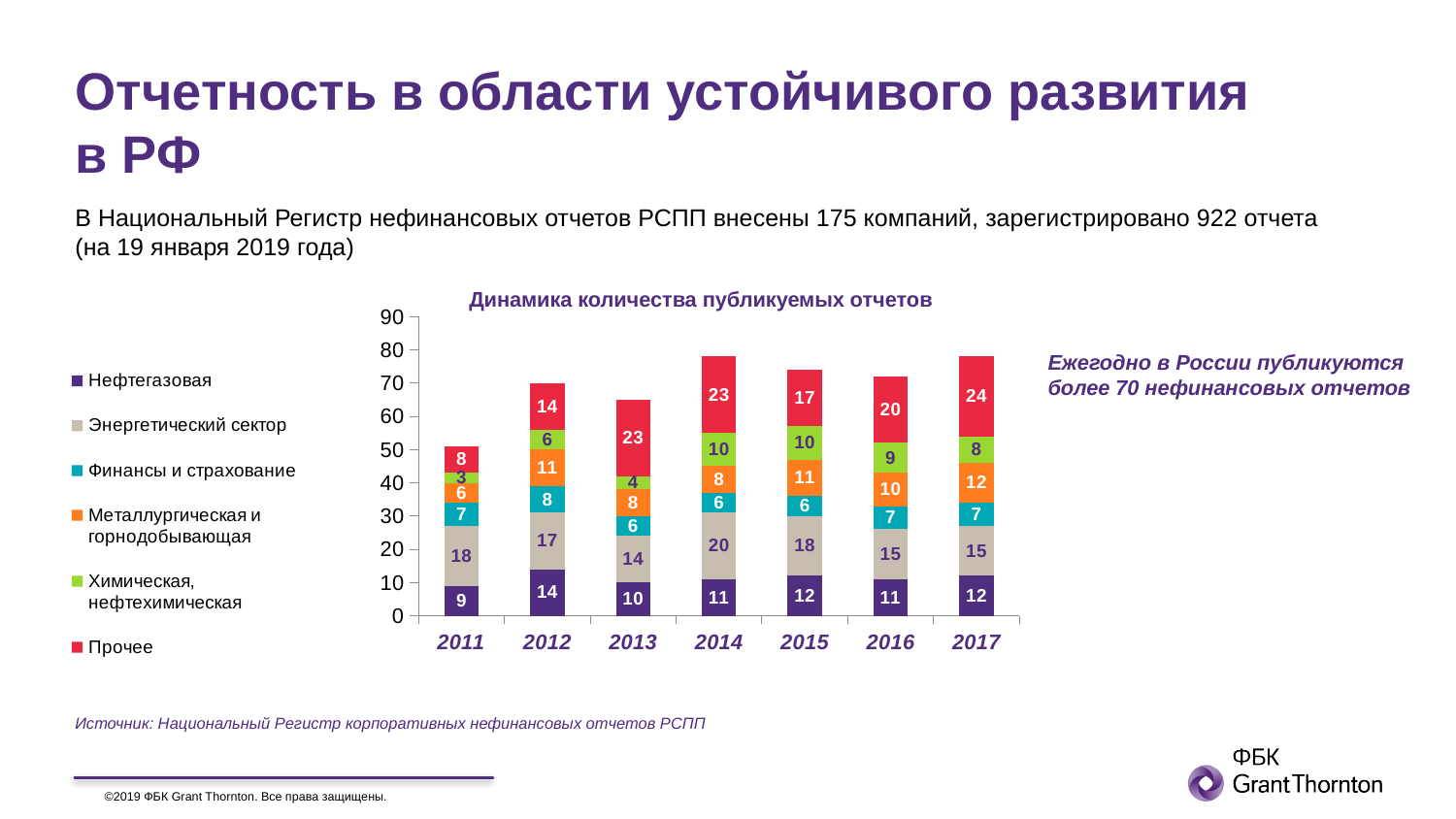
In which year is the Нефтегазовая value lowest? 2011 What is the value for Прочее in 2017? 24 What is the value for Энергетический сектор in 2014? 20 Which is larger: Металлургическая и горнодобывающая in 2017 or Финансы и страхование in 2017? Металлургическая и горнодобывающая What is the title of the chart? Динамика количества публикуемых отчетов What is the difference between the Энергетический сектор values in 2011 and 2013? 4 What is the total of the stacked bar for 2011? 51 In which year is the Прочее value highest? 2017 How many years are shown on the x axis? 7 How many series does the legend list? 6 What is the value for Нефтегазовая in 2012? 14 What type of chart is shown on the slide? stacked bar chart